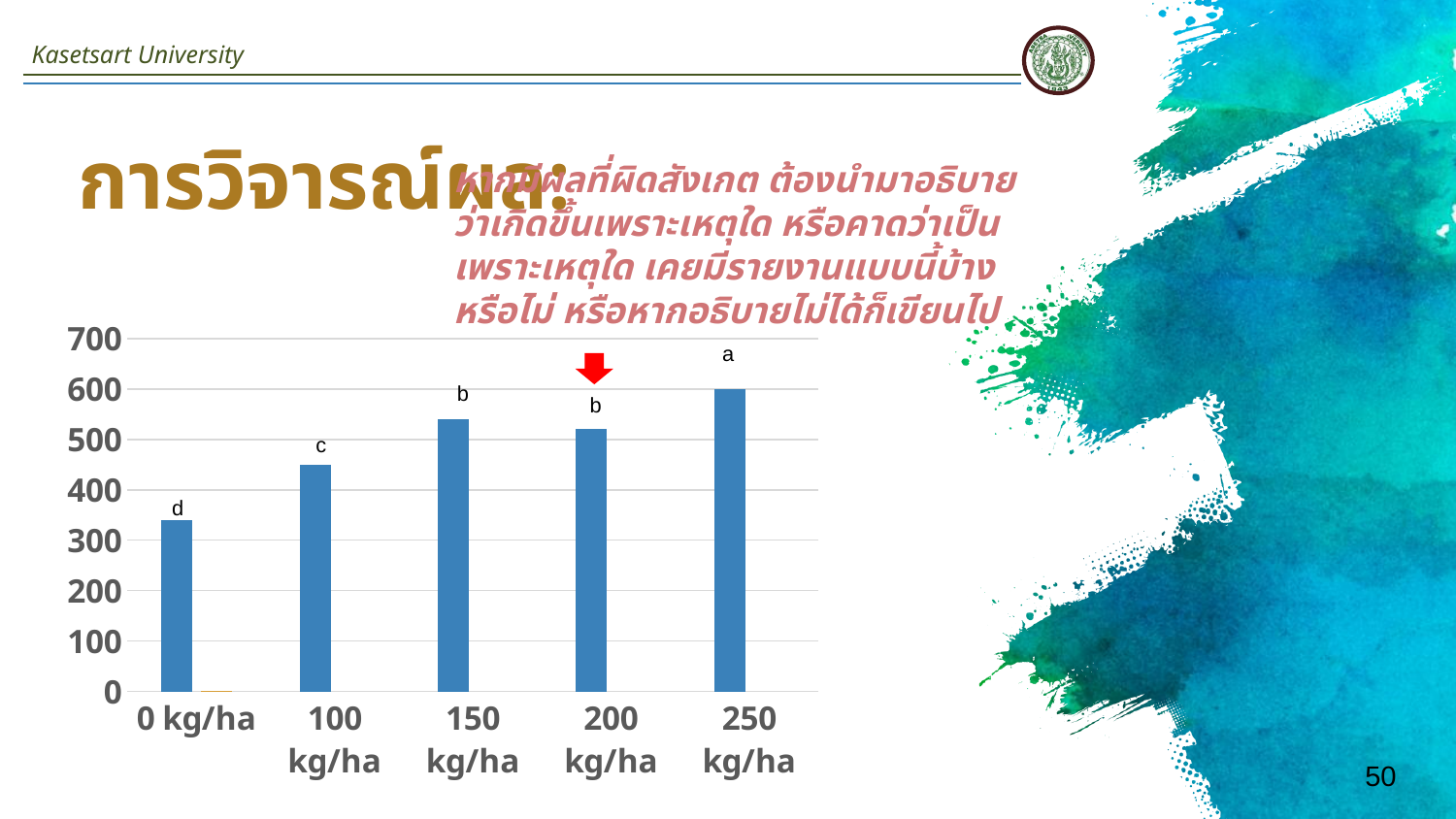
Is the value for 200 kg/ha greater or less than 600? less Is the value for 0 kg/ha greater or less than 400? less Which category has the highest bar in the chart? 250 kg/ha Which is larger, the value for 0 kg/ha or the value for 100 kg/ha? 100 kg/ha Do the values rise or fall from 0 kg/ha to 150 kg/ha? rise How many categories are shown on the x axis of the chart? 5 What kind of chart is shown on the slide? bar chart Is the value for 100 kg/ha greater or less than 400? greater Which is larger, the value for 100 kg/ha or the value for 150 kg/ha? 150 kg/ha Which category has the lowest bar in the chart? 0 kg/ha Which category's bar has the red arrow pointing at it? 200 kg/ha